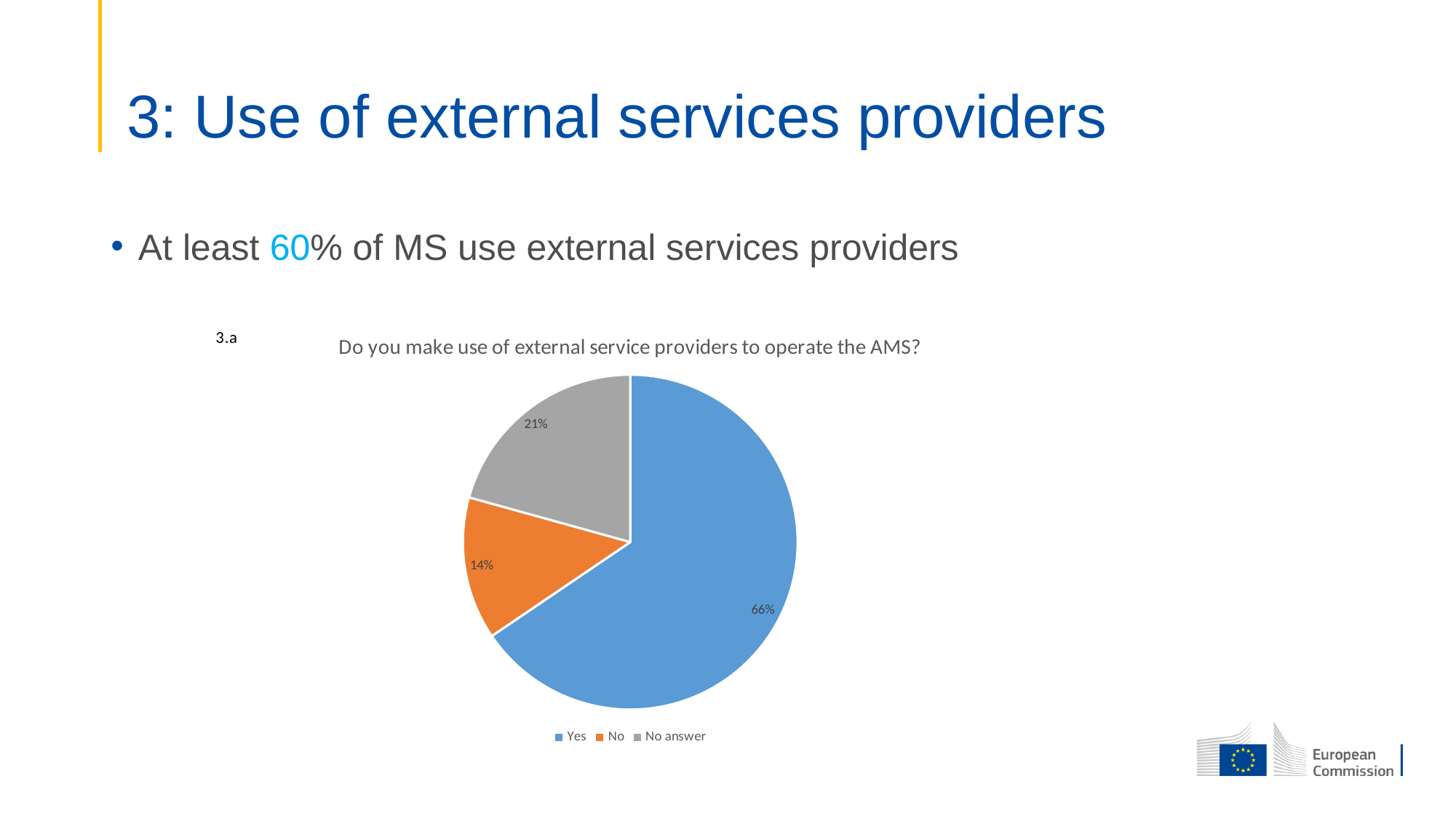
Which slice is larger, "No" or "No answer"? No answer How many entries does the legend list? 3 What share of the pie is labelled "No answer"? 21% Which category has the smallest slice of the pie? No What is the chart's title? Do you make use of external service providers to operate the AMS? How many slices does the pie chart have? 3 What share of the pie is labelled "No"? 14% What is the difference in percentage points between the "Yes" slice and the "No answer" slice? 45 Which category has the largest slice of the pie? Yes What share of the pie is labelled "Yes"? 66% What colour is the "Yes" slice? blue What type of chart is shown on the slide? pie chart